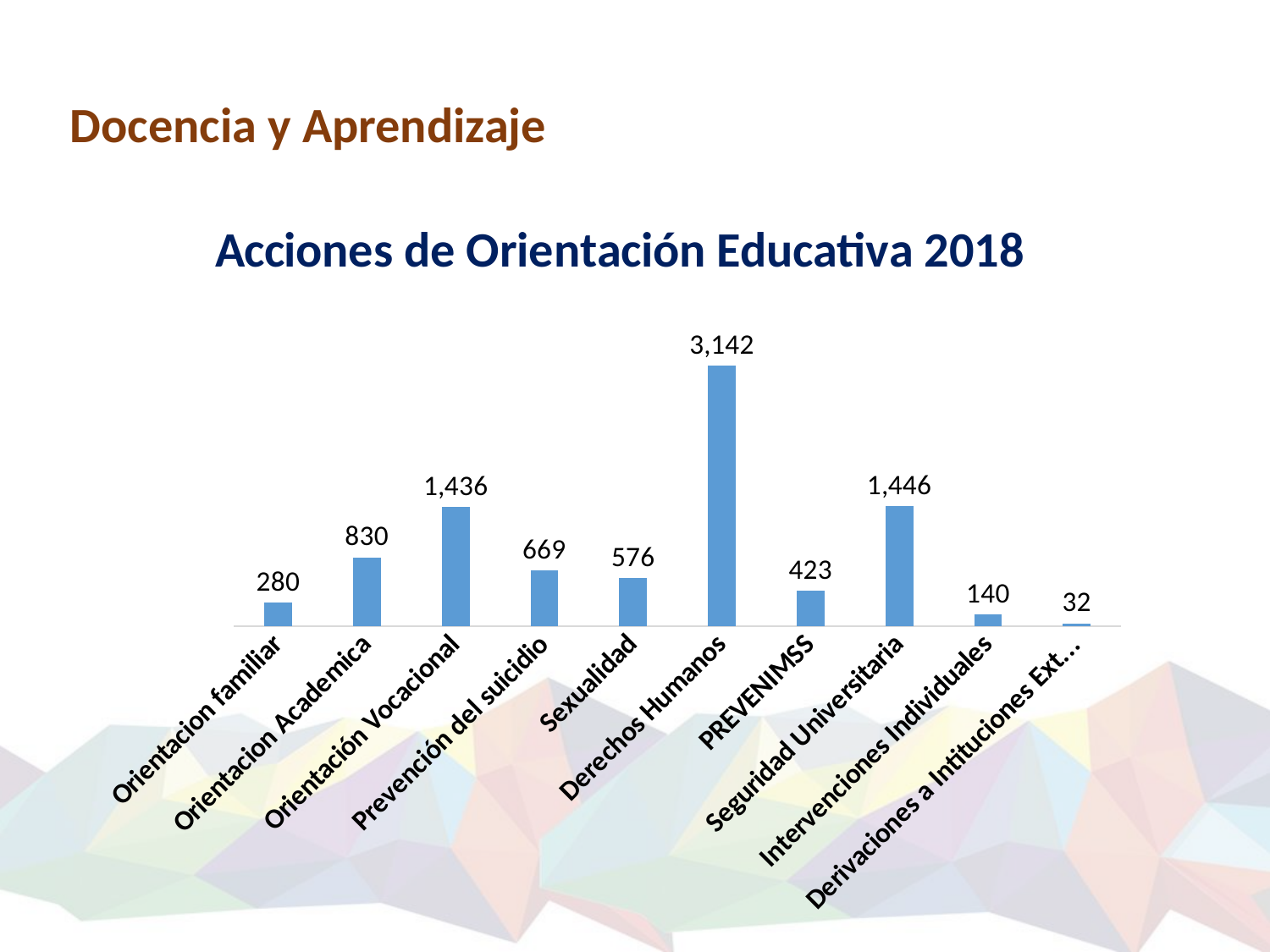
What is the difference between the values for Derechos Humanos and Seguridad Universitaria? 1,696 Which category has the lowest value? Derivaciones a Intituciones Ext... What is the title of the chart? Acciones de Orientación Educativa 2018 What type of chart is shown on the slide? bar chart What is the value for Intervenciones Individuales? 140 Which is larger, the value for Prevención del suicidio or the value for Sexualidad? Prevención del suicidio What is the value for PREVENIMSS? 423 Which category has the highest value? Derechos Humanos What is the difference between the values for Orientacion Academica and Orientacion familiar? 550 What is the value for Derechos Humanos? 3,142 How many categories are shown in the chart? 10 What is the value for Orientacion Academica? 830